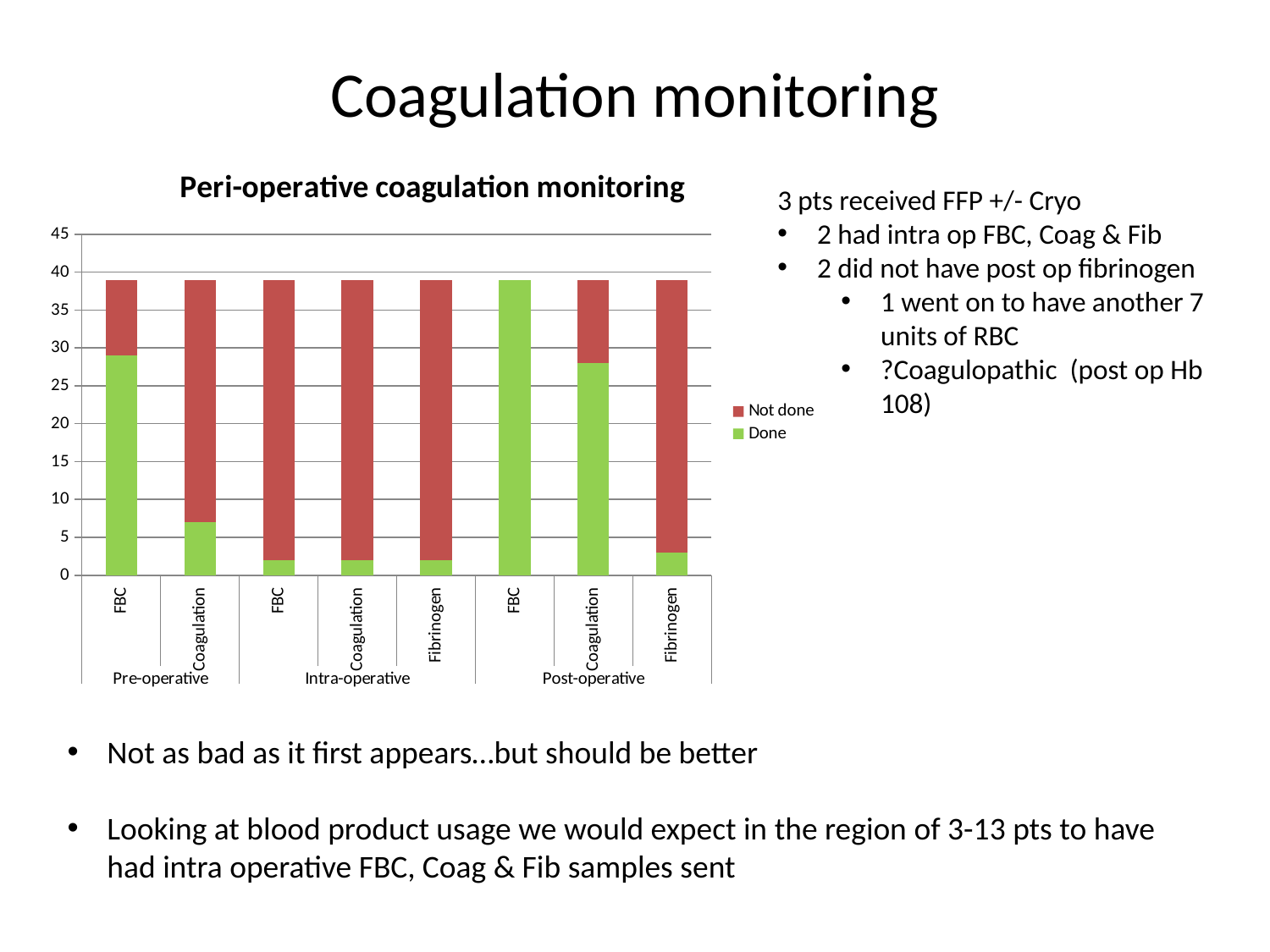
Which colour represents the 'Done' series in the chart? Green Which bar has the largest 'Done' portion? Post-operative FBC Is the 'Done' value for Intra-operative Fibrinogen greater or less than 5? less What is the title of the chart? Peri-operative coagulation monitoring Is the 'Done' value for Pre-operative Coagulation greater or less than 10? less How many series does the chart legend list? 2 What kind of chart is shown on the slide? Stacked bar chart Which has the larger 'Done' value: Post-operative Coagulation or Post-operative Fibrinogen? Post-operative Coagulation How many bars are plotted in the chart? 8 Which bar has no 'Not done' portion at all? Post-operative FBC Is the 'Done' value for Pre-operative FBC greater or less than 25? greater Which has the larger 'Done' value: Pre-operative FBC or Pre-operative Coagulation? Pre-operative FBC